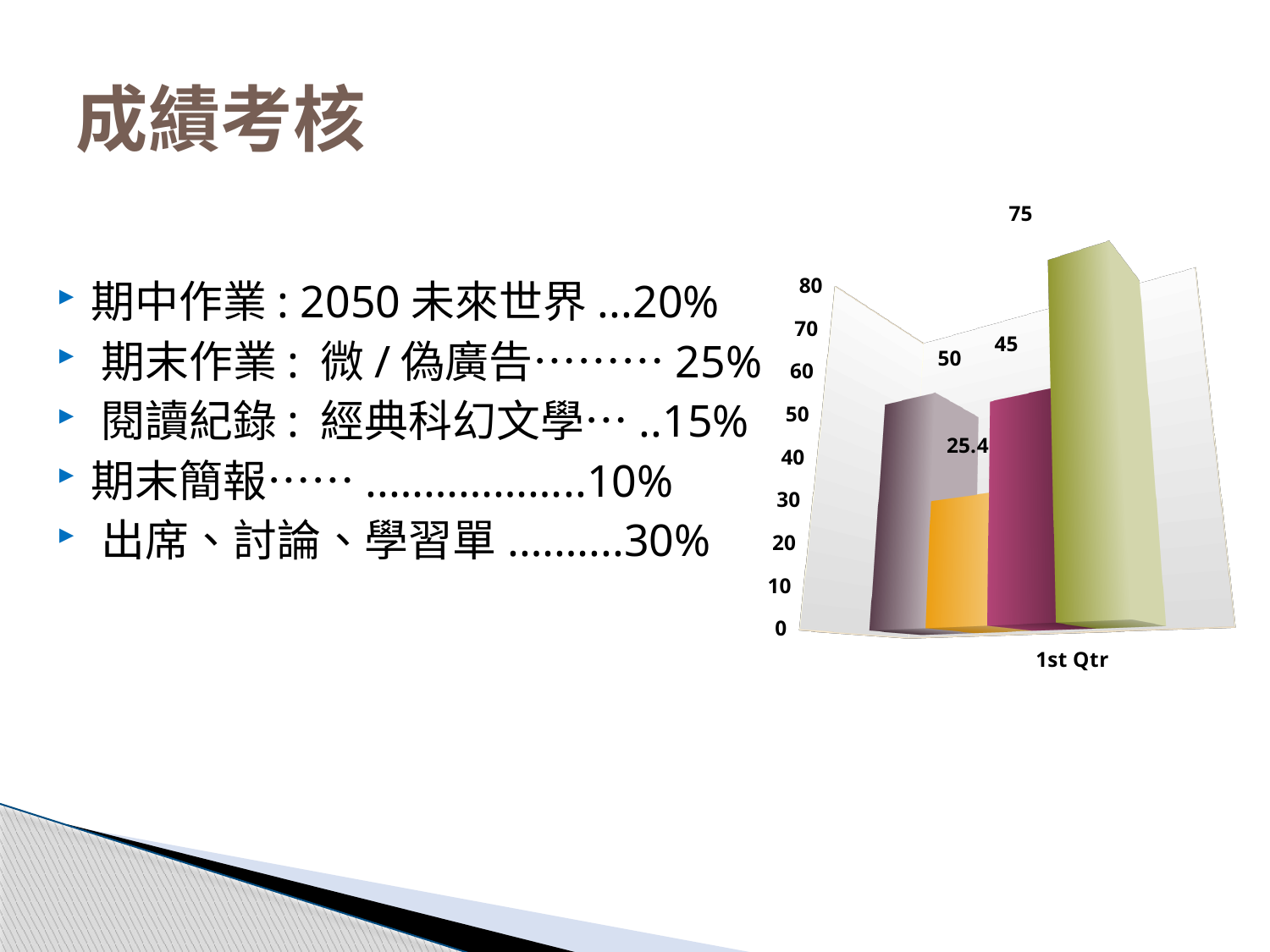
How many bars are plotted in the chart? 4 How many categories are shown on the x axis of the chart? 1 What is the category label shown on the x axis of the chart? 1st Qtr What kind of chart is shown on the slide? bar chart What is the value labelled on the green bar in the chart? 75 What is the difference between the highest and lowest labelled values in the chart? 49.6 What is the difference between the values labelled 50 and 45 in the chart? 5 Which is larger, the value on the grey bar or the value on the magenta bar? the grey bar (50) What is the lowest value labelled in the chart? 25.4 Is the value of the tallest bar greater or less than 70? greater What is the value labelled on the orange bar in the chart? 25.4 What is the highest value labelled in the chart? 75